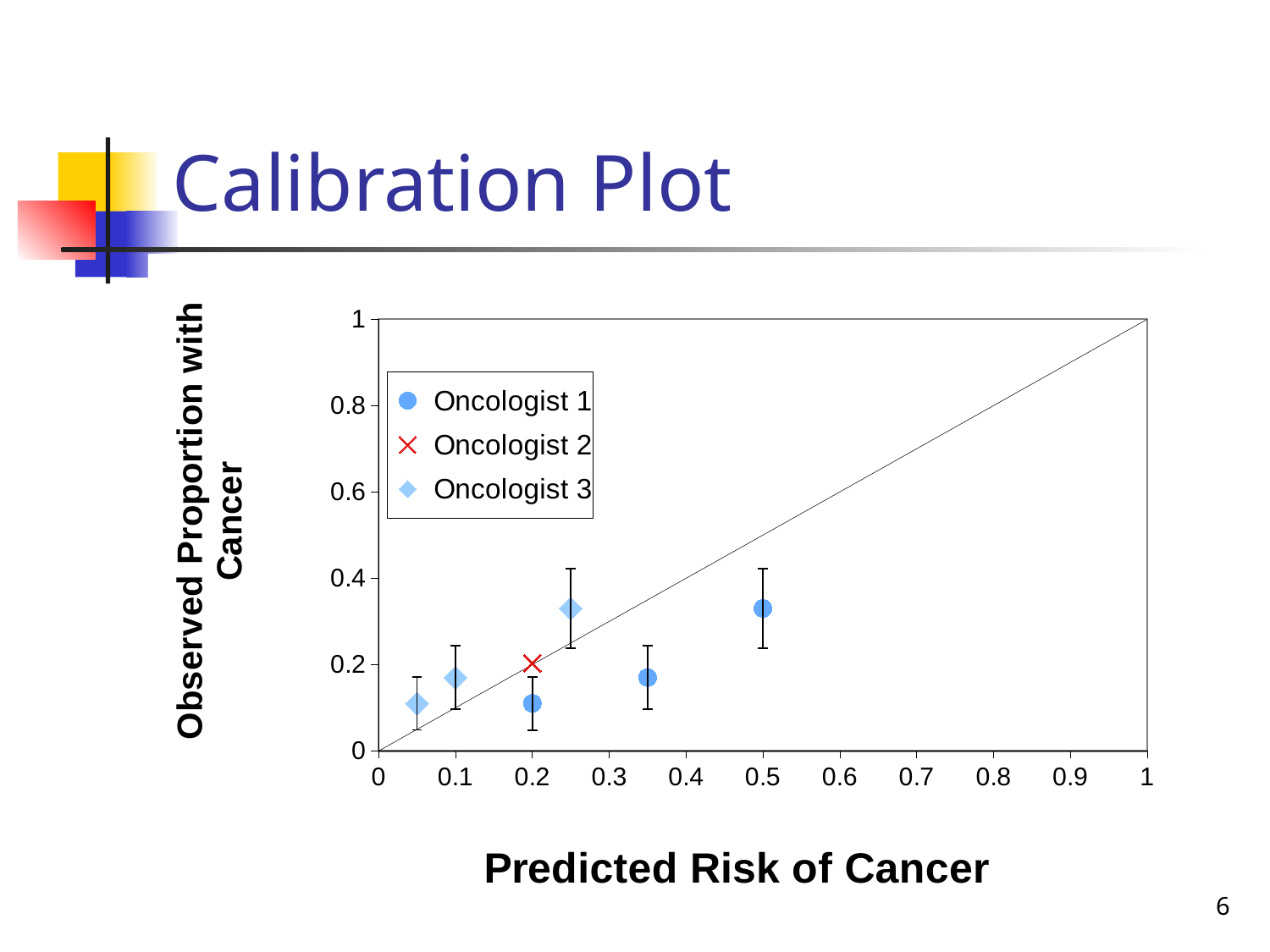
Is the observed proportion for Oncologist 1 at a predicted risk of 0.5 greater or less than 0.2? greater Do the Oncologist 1 points rise or fall in observed proportion as predicted risk increases? rise How many data points are plotted for Oncologist 2? 1 How many series does the legend list? 3 Is the observed proportion for Oncologist 1 at a predicted risk of 0.2 greater or less than 0.2? less What kind of chart is shown on the slide? Scatter plot What is the title of the chart? Calibration Plot At what predicted risk of cancer is the single Oncologist 2 point plotted? 0.2 How many data points are plotted for Oncologist 1? 3 Which Oncologist 1 point has the highest observed proportion: the one at predicted risk 0.2 or the one at 0.5? 0.5 How many data points are plotted for Oncologist 3? 3 What is the label of the x axis? Predicted Risk of Cancer